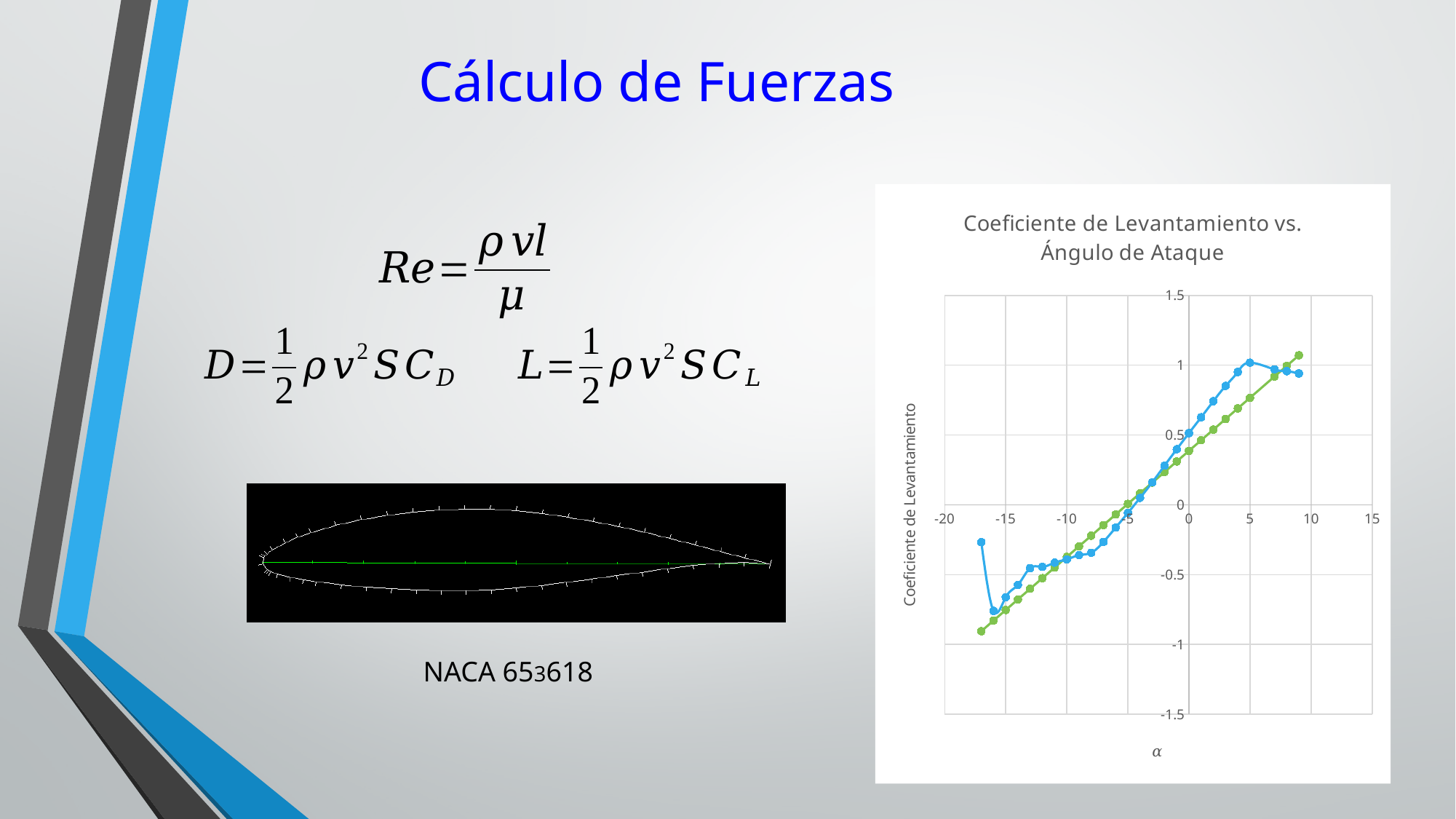
Is the value of the blue series at α = -17 greater or less than -0.5? greater What kind of chart is shown on the slide? line chart Is the value of the blue series at α = 5 greater or less than 0.5? greater Overall, do the values of the lift coefficient rise or fall as the angle of attack α increases along the x axis? rise Is the value of the green series at α = -15 greater or less than -0.5? less At which angle of attack does the green series reach its lowest lift coefficient? -17 At which angle of attack does the blue series reach its highest lift coefficient? 5 What is the title of the chart on the slide? Coeficiente de Levantamiento vs. Ángulo de Ataque What is the label of the vertical axis of the chart? Coeficiente de Levantamiento At α = 5, which series has the larger lift coefficient, the blue one or the green one? blue How many data series are plotted in the chart? 2